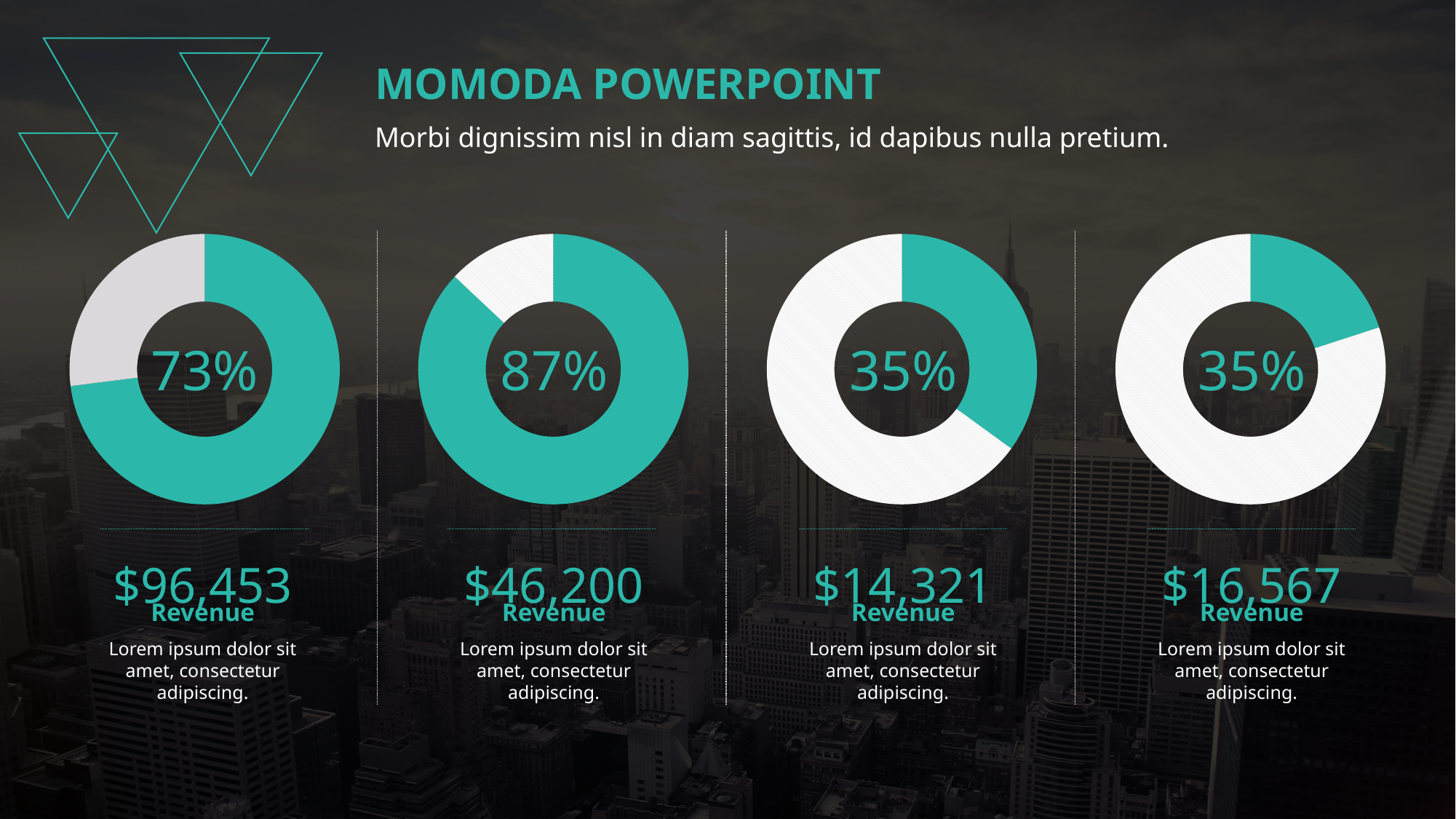
What percentage is shown in the centre of the third donut chart? 35% Which donut chart shows the highest percentage? The second donut chart (87%) What kind of chart is used for each of the four figures on the slide? Donut chart How many donut charts are shown on the slide? 4 What revenue figure is printed below the third donut chart? $14,321 Which donut chart has the lowest revenue figure printed below it? The third donut chart ($14,321) What percentage is shown in the centre of the first (leftmost) donut chart? 73% What revenue figure is printed below the first (leftmost) donut chart? $96,453 Which is larger, the percentage in the first donut chart or the percentage in the third donut chart? The first donut chart (73%) What is the difference between the percentages shown in the second and first donut charts? 14% What colour is the filled portion of each donut chart? Teal What percentage is shown in the centre of the second donut chart? 87%